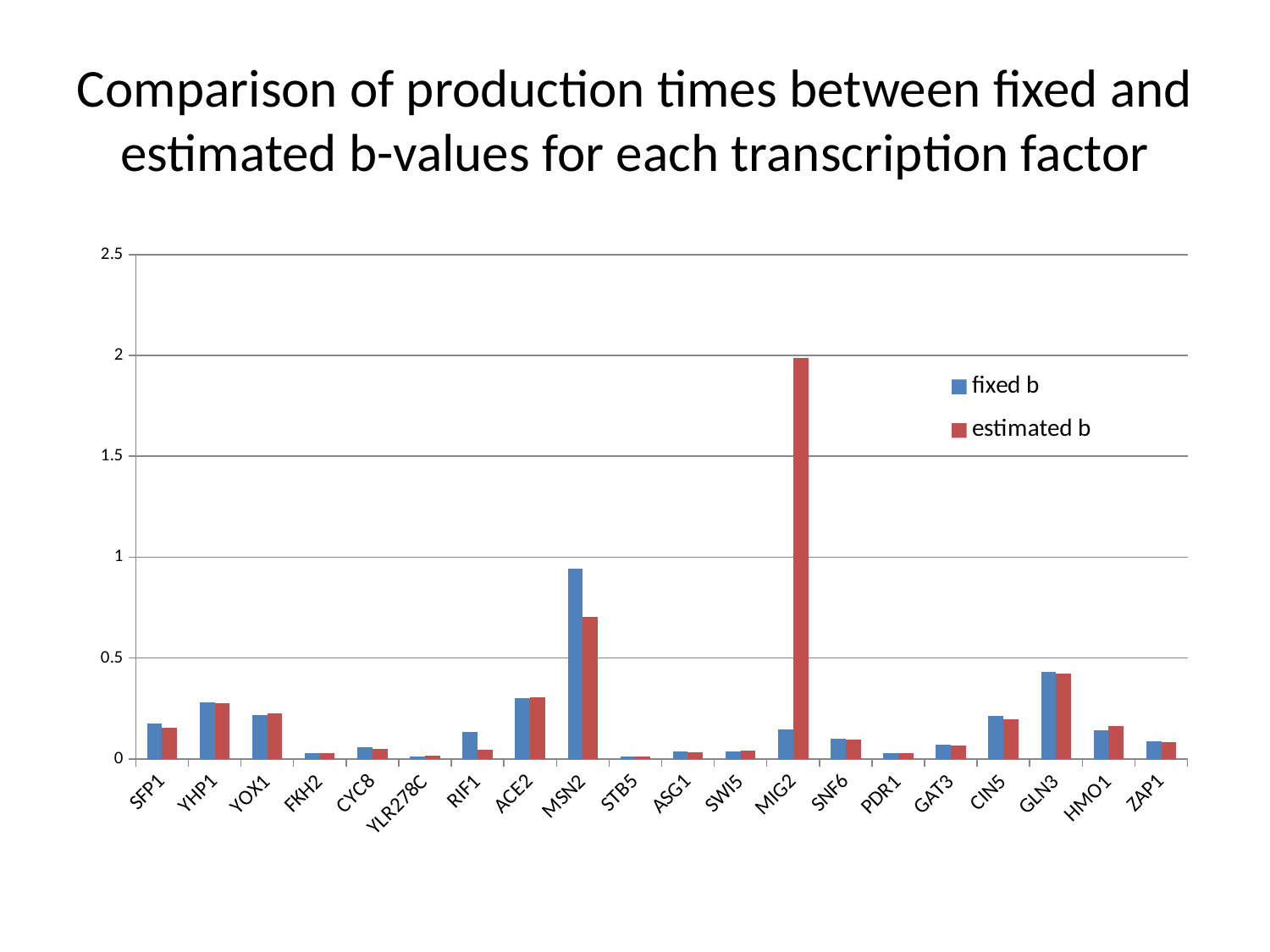
Is the fixed b value for MIG2 greater or less than 0.5? less Which transcription factor has the highest estimated b value? MIG2 Is the fixed b value for MSN2 greater or less than 1? less Which colour represents the estimated b series in the legend? red For MSN2, which is larger: the fixed b value or the estimated b value? fixed b How many transcription factors are shown on the x axis? 20 For MIG2, which is larger: the fixed b value or the estimated b value? estimated b How many series does the legend list? 2 Which transcription factor has the highest fixed b value? MSN2 Is the estimated b value for MIG2 greater or less than 1.5? greater What kind of chart is shown on the slide? bar chart